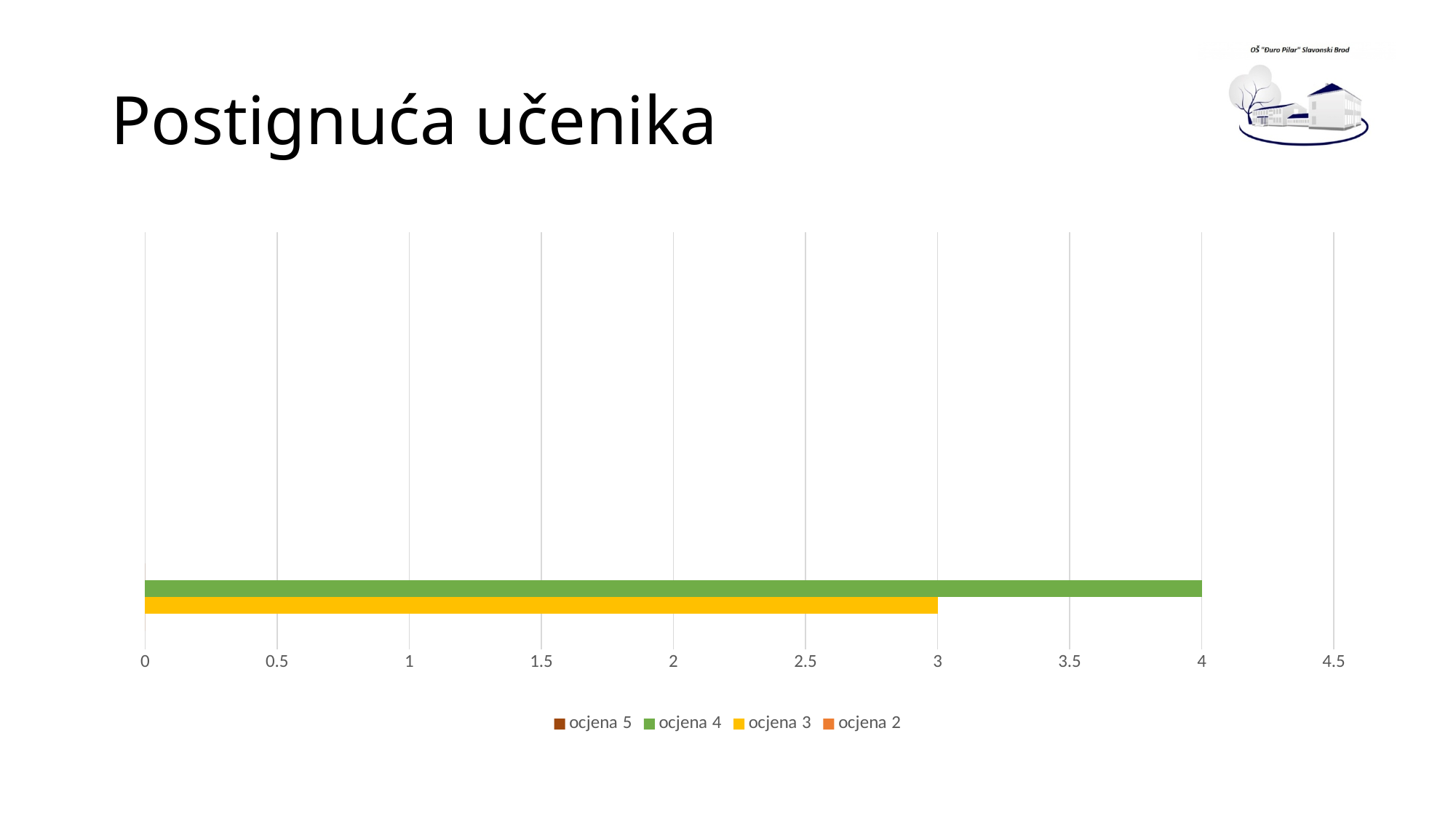
Which has the larger value, ocjena 4 or ocjena 3? ocjena 4 What is the value of the bar for ocjena 3? 3 How many series does the legend list? 4 Is the value for ocjena 4 greater or less than 3.5? greater What is the value of the bar for ocjena 4? 4 Is the value for ocjena 3 greater or less than 3.5? less What is the difference between the values for ocjena 4 and ocjena 3? 1 What is the highest tick value shown on the horizontal axis? 4.5 Which series has the longest bar in the chart? ocjena 4 What kind of chart is shown on the slide? bar chart What colour is the bar for ocjena 4? green